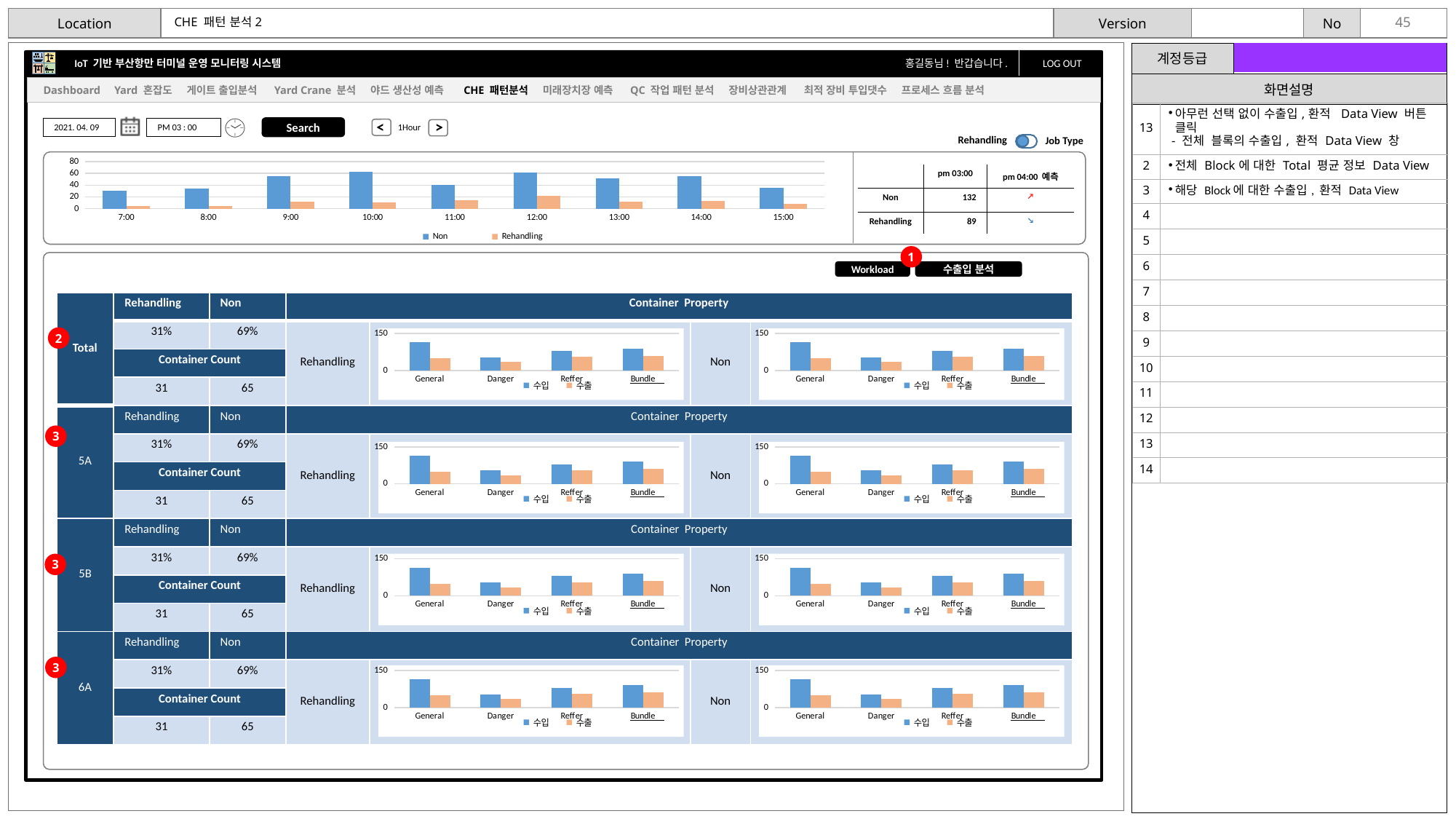
In the Total row's Rehandling Container Property chart, which category has the highest 수입 bar? General In the top hourly chart, which Non bar is taller: 9:00 or 7:00? 9:00 How many series does the legend of the top hourly chart list? 2 In the Total row's Rehandling Container Property chart, how many categories are on the x axis? 4 How many time categories are shown on the x axis of the top hourly chart? 9 In the top hourly chart, which is larger at 12:00: the Non bar or the Rehandling bar? Non What kind of chart is the hourly chart at the top of the screen (7:00 to 15:00)? bar chart What are the two series named in the legend of the top hourly chart? Non and Rehandling In the top hourly chart, is the Non value at 10:00 greater or less than 40? greater In the top hourly chart, at which time is the Rehandling bar highest? 12:00 In the top hourly chart, is the Non value at 7:00 greater or less than 40? less In the top hourly chart, is the Rehandling value at 7:00 greater or less than 20? less